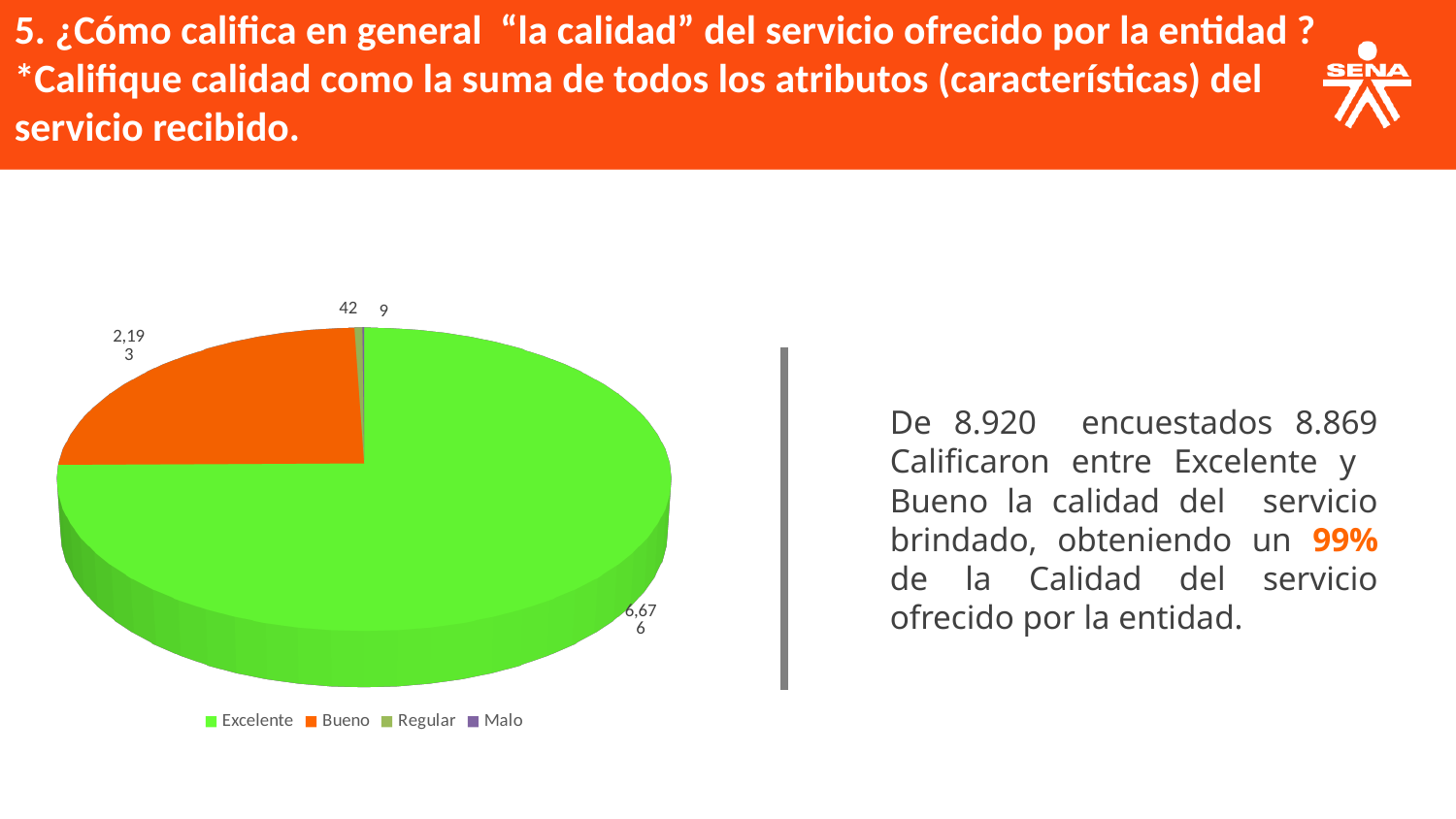
What value is shown for Excelente in the pie chart? 6,676 What value is shown for Malo in the pie chart? 9 Which category has the smallest slice of the pie chart? Malo What value is shown for Regular in the pie chart? 42 What is the difference between the values for Regular and Malo in the pie chart? 33 How many categories does the pie chart's legend list? 4 Which is larger in the pie chart, Excelente or Bueno? Excelente What colour represents Bueno in the pie chart? orange Which is larger in the pie chart, Regular or Malo? Regular What value is shown for Bueno in the pie chart? 2,193 Which category has the largest slice of the pie chart? Excelente What kind of chart is shown on the slide? pie chart